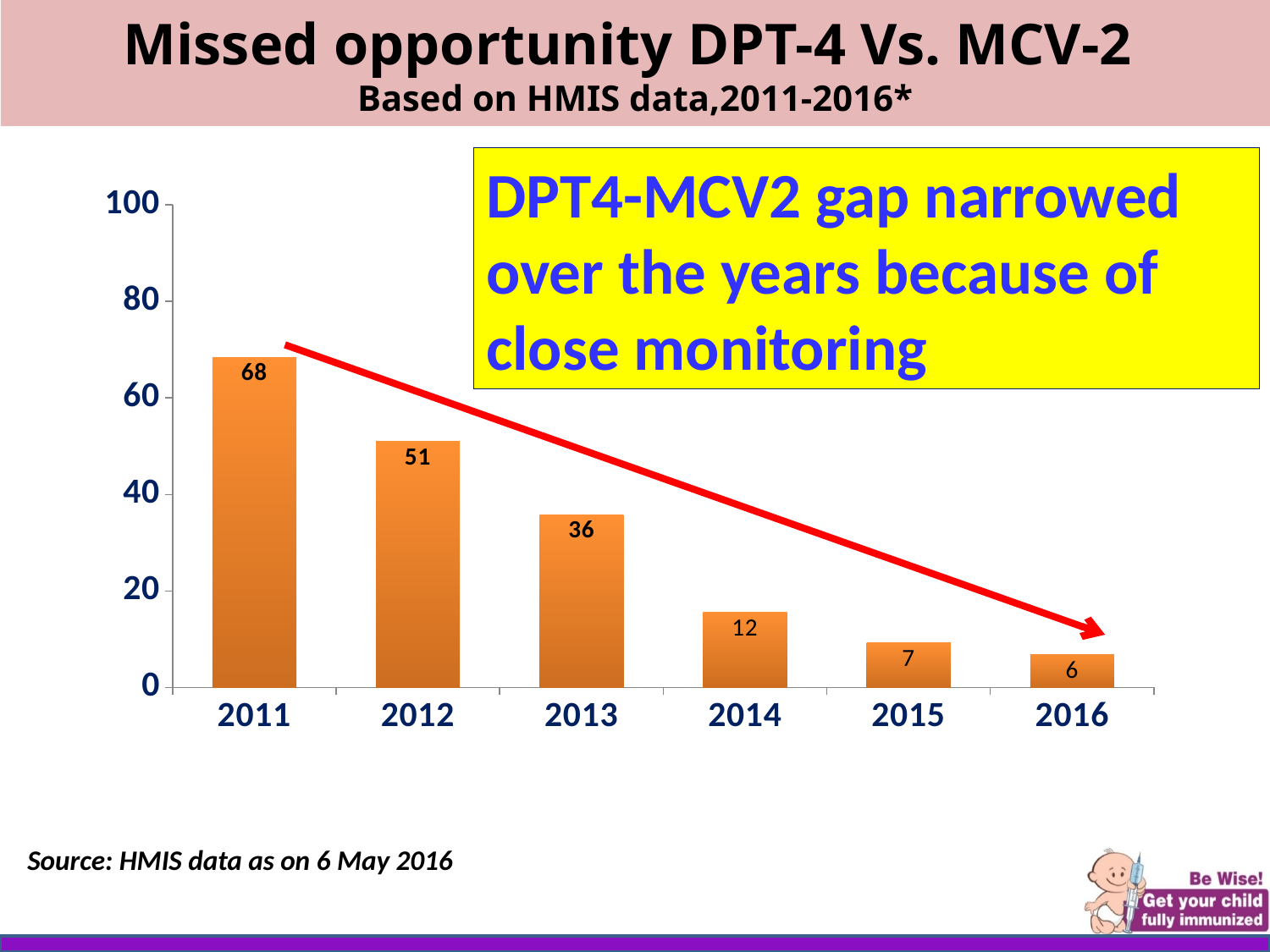
Which year has the lowest value? 2016 Do the values rise or fall from 2011 to 2016? Fall What kind of chart is shown on the slide? Bar chart Is the value for 2012 greater or less than 40? greater Which year has the highest value? 2011 What is the difference between the values for 2011 and 2012? 17 What is the value for 2011? 68 What is the difference between the values for 2014 and 2015? 5 What is the value for 2016? 6 What is the value for 2013? 36 How many years are shown on the x axis? 6 Which is larger, the value for 2012 or the value for 2013? 2012